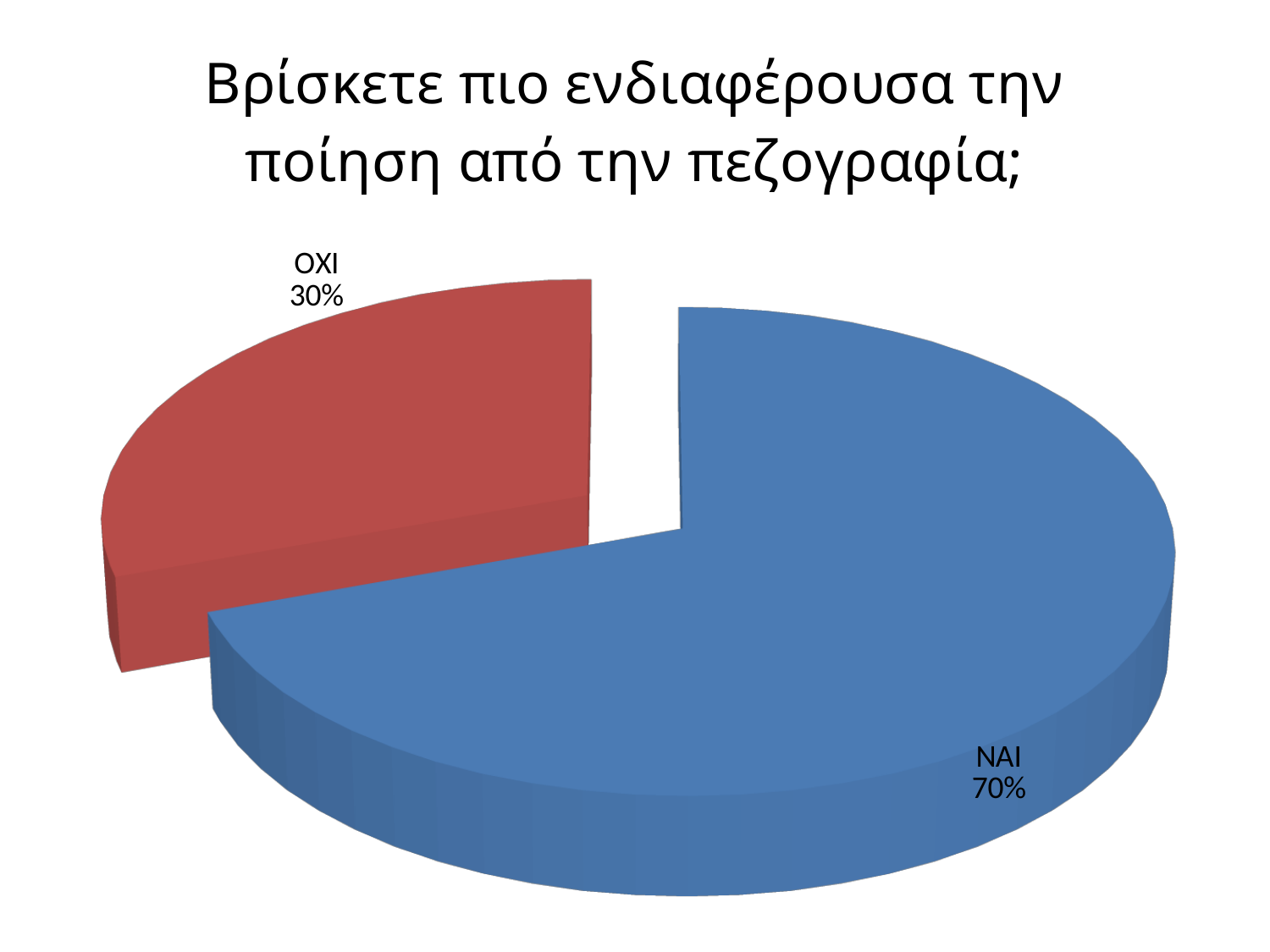
What is the difference in percentage points between the ΝΑΙ and ΟΧΙ slices? 40 Which slice is the largest? ΝΑΙ Which slice is the smallest? ΟΧΙ What kind of chart is shown on the slide? Pie chart Which is larger, the ΝΑΙ slice or the ΟΧΙ slice? ΝΑΙ What colour is the ΝΑΙ slice? Blue What is the title of the chart? Βρίσκετε πιο ενδιαφέρουσα την ποίηση από την πεζογραφία; How many slices does the pie chart have? 2 What percentage is shown for the ΟΧΙ slice? 30% What share of the pie does the ΟΧΙ slice represent? 30% What percentage is shown for the ΝΑΙ slice? 70%